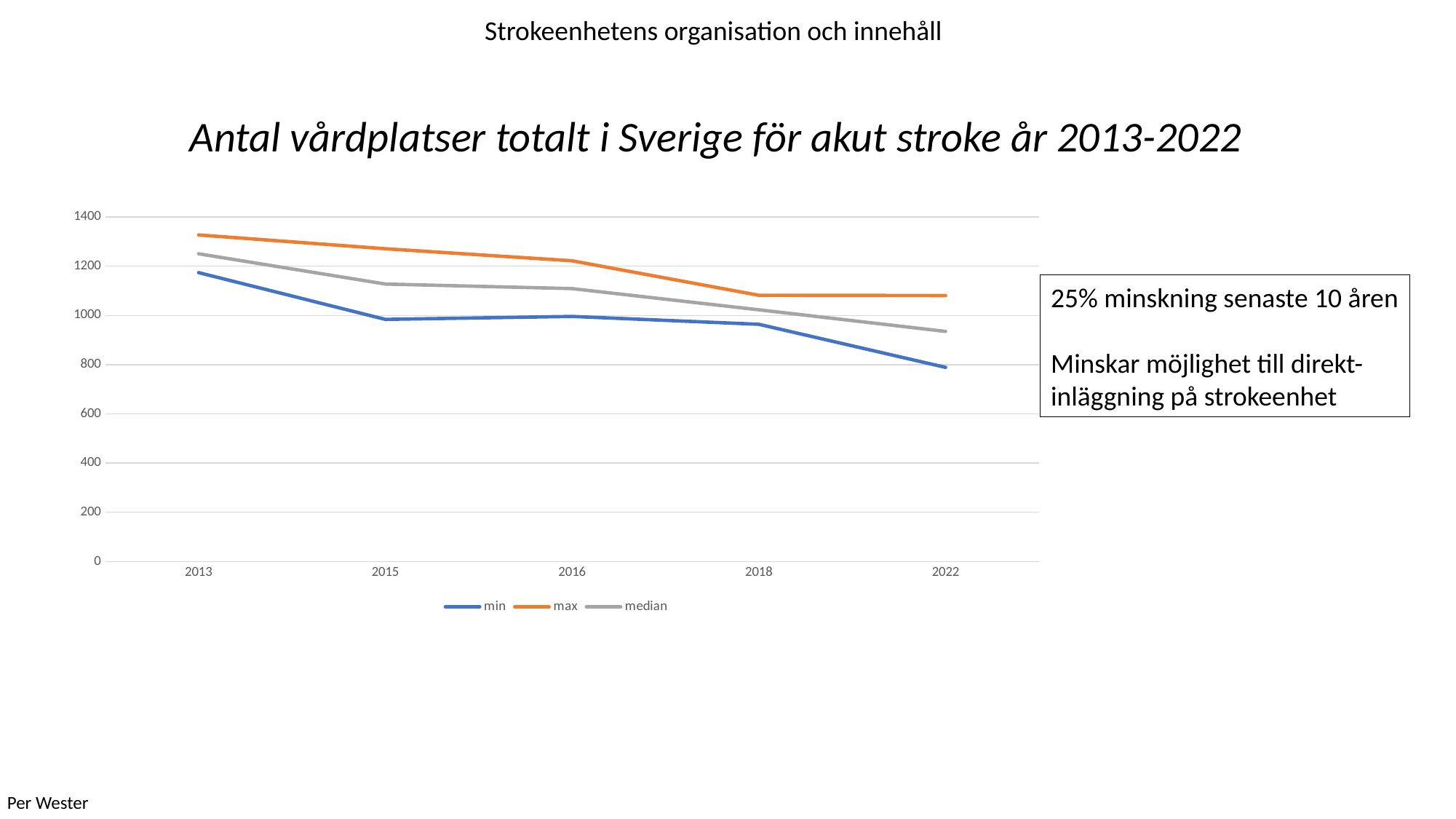
Does the min series rise or fall from 2013 to 2022? fall In which year is the min series at its highest? 2013 Is the value for min in 2022 greater or less than 1000? less Is the value for min in 2013 greater or less than 1000? greater Does the median series rise or fall from 2013 to 2022? fall How many years are plotted along the x axis? 5 What kind of chart is shown on the slide? line chart Is the value for median in 2022 greater or less than 1000? less Which series has the larger value in 2016, max or min? max How many series does the legend list? 3 In which year is the median series at its lowest? 2022